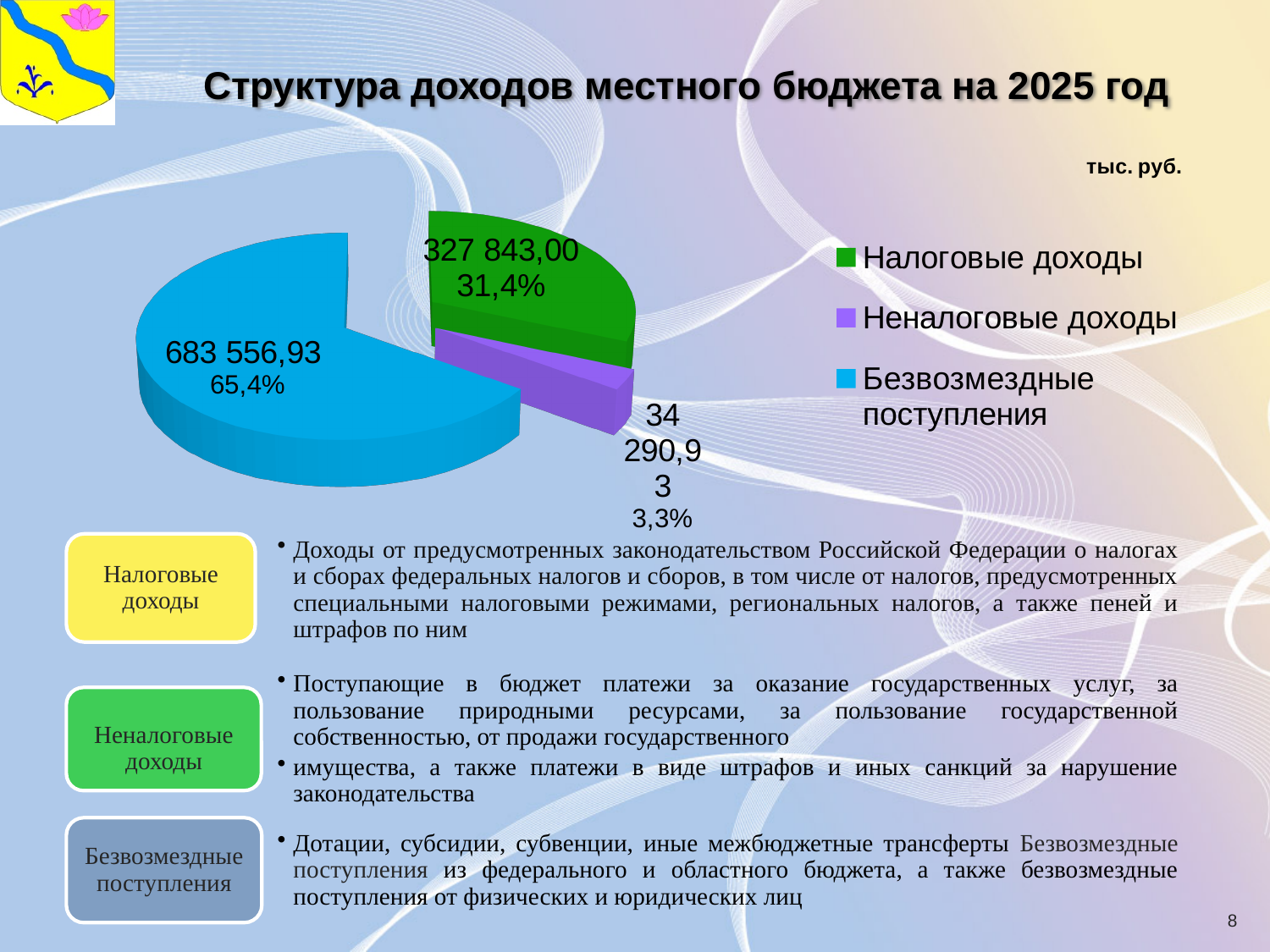
What is the value for Неналоговые доходы? 34 290,93 Which category has the largest slice? Безвозмездные поступления What share of the pie does Безвозмездные поступления take? 65,4% What share of the pie does Неналоговые доходы take? 3,3% What is the value for Безвозмездные поступления? 683 556,93 What is the title of the slide's chart? Структура доходов местного бюджета на 2025 год Which is larger, Налоговые доходы or Неналоговые доходы? Налоговые доходы What is the value for Налоговые доходы? 327 843,00 What kind of chart is shown on the slide? pie chart What is the difference between the values for Безвозмездные поступления and Налоговые доходы? 355 713,93 How many categories does the pie chart have? 3 Which category has the smallest slice? Неналоговые доходы